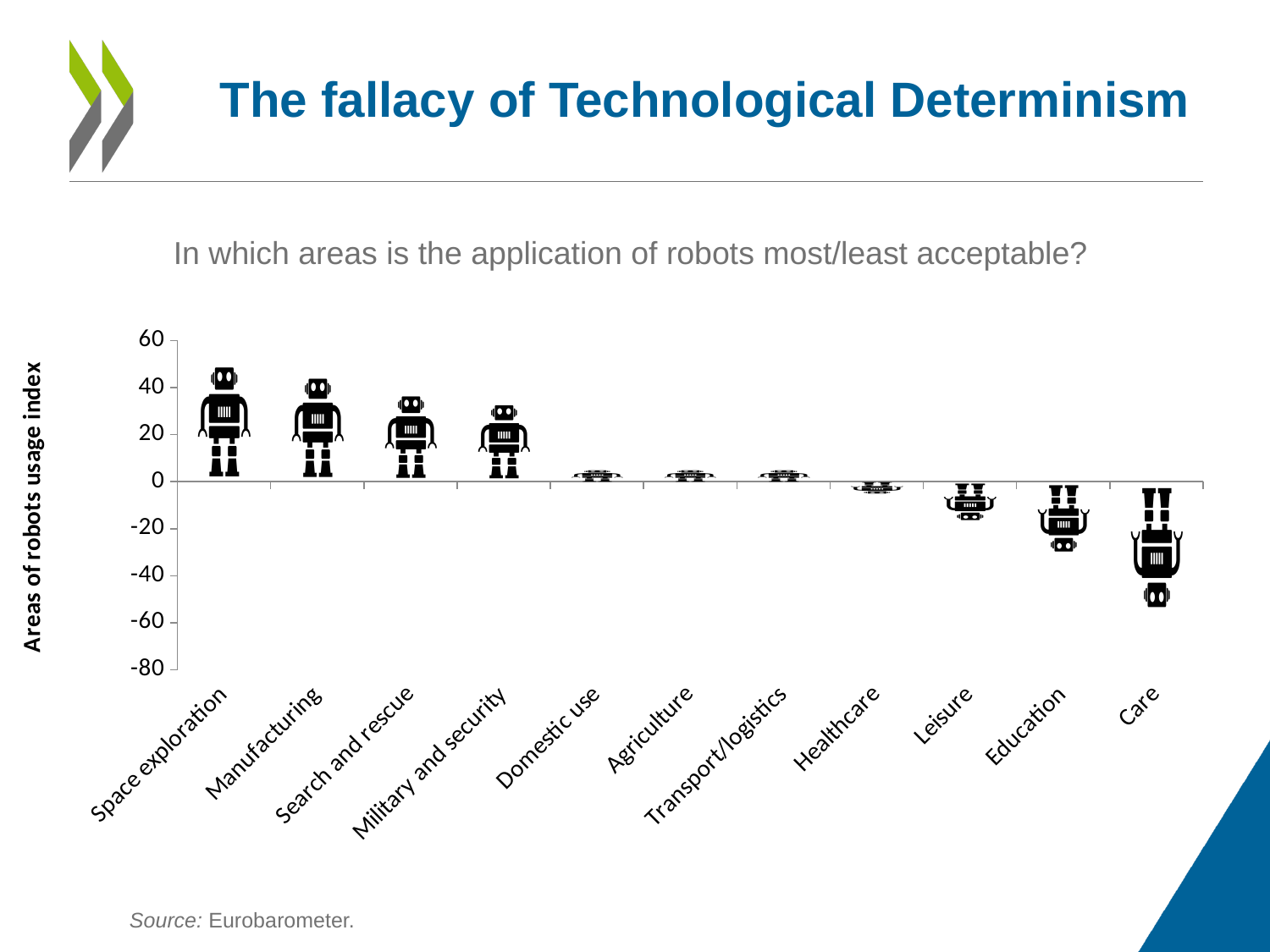
Which area has the lowest value on the robots usage index? Care Do the values rise or fall moving from left to right along the x axis? fall Is the value for Care greater or less than -40? less Is the value for Space exploration greater or less than 40? greater How many areas are shown along the x axis of the chart? 11 Which area has the highest value on the robots usage index? Space exploration What is the label on the vertical axis of the chart? Areas of robots usage index What kind of chart is shown on the slide? Bar chart (pictograph with robot icons) Which has the larger value, Manufacturing or Education? Manufacturing Is the value for Leisure greater or less than -20? greater